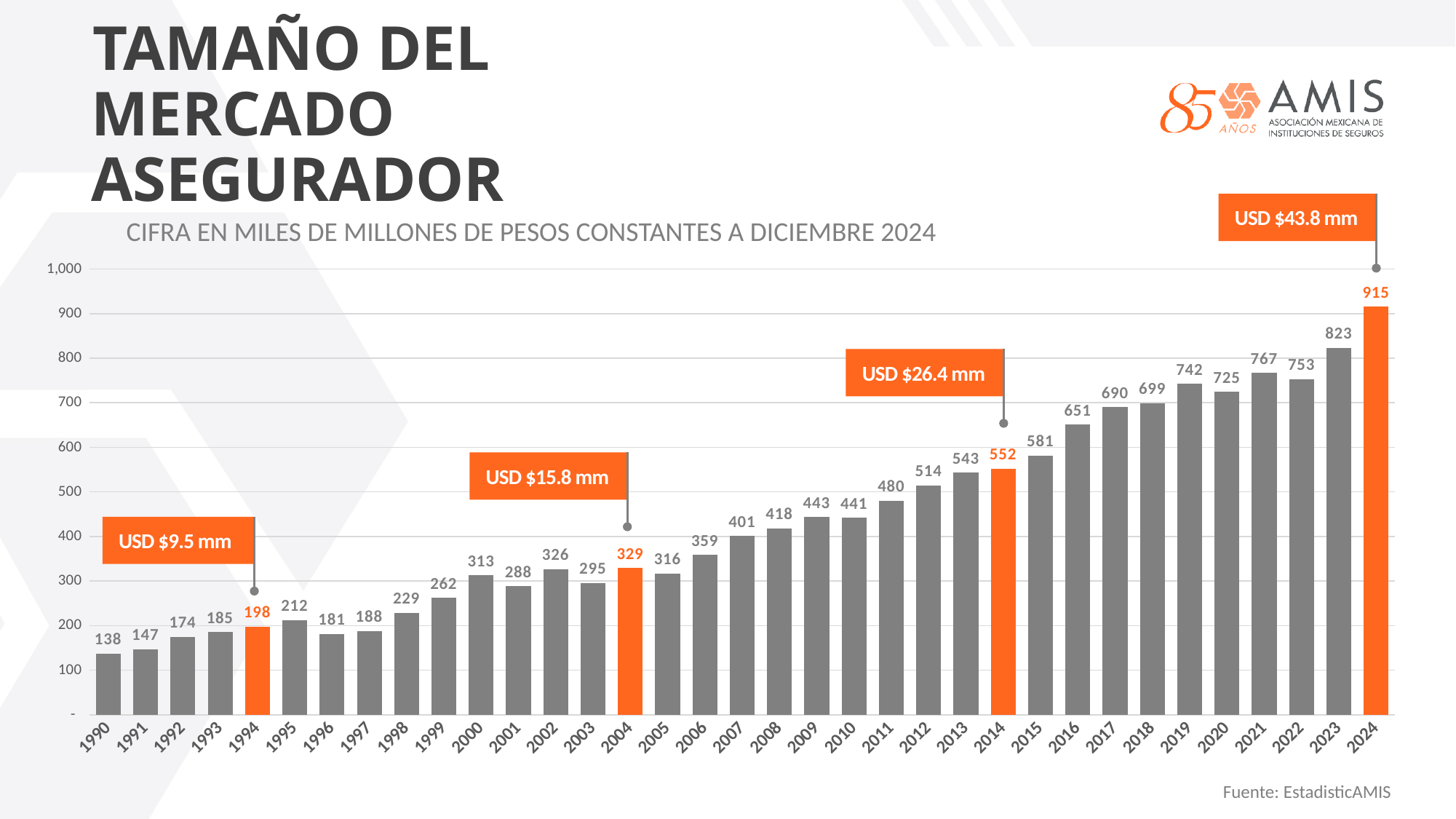
Do the values generally rise or fall from 1990 to 2024? Rise What kind of chart is shown on the slide? Bar chart What is the value for 1990? 138 What USD amount is shown in the callout above the 2024 bar? USD $43.8 mm What is the value for 2014? 552 Which year has the highest value? 2024 What is the value for 2024? 915 Which is larger, the value for 2021 or the value for 2022? 2021 Is the value for 2016 greater or less than 600? greater What is the difference between the values for 2024 and 2023? 92 How many years are shown on the x axis? 35 Which year has the lowest value? 1990